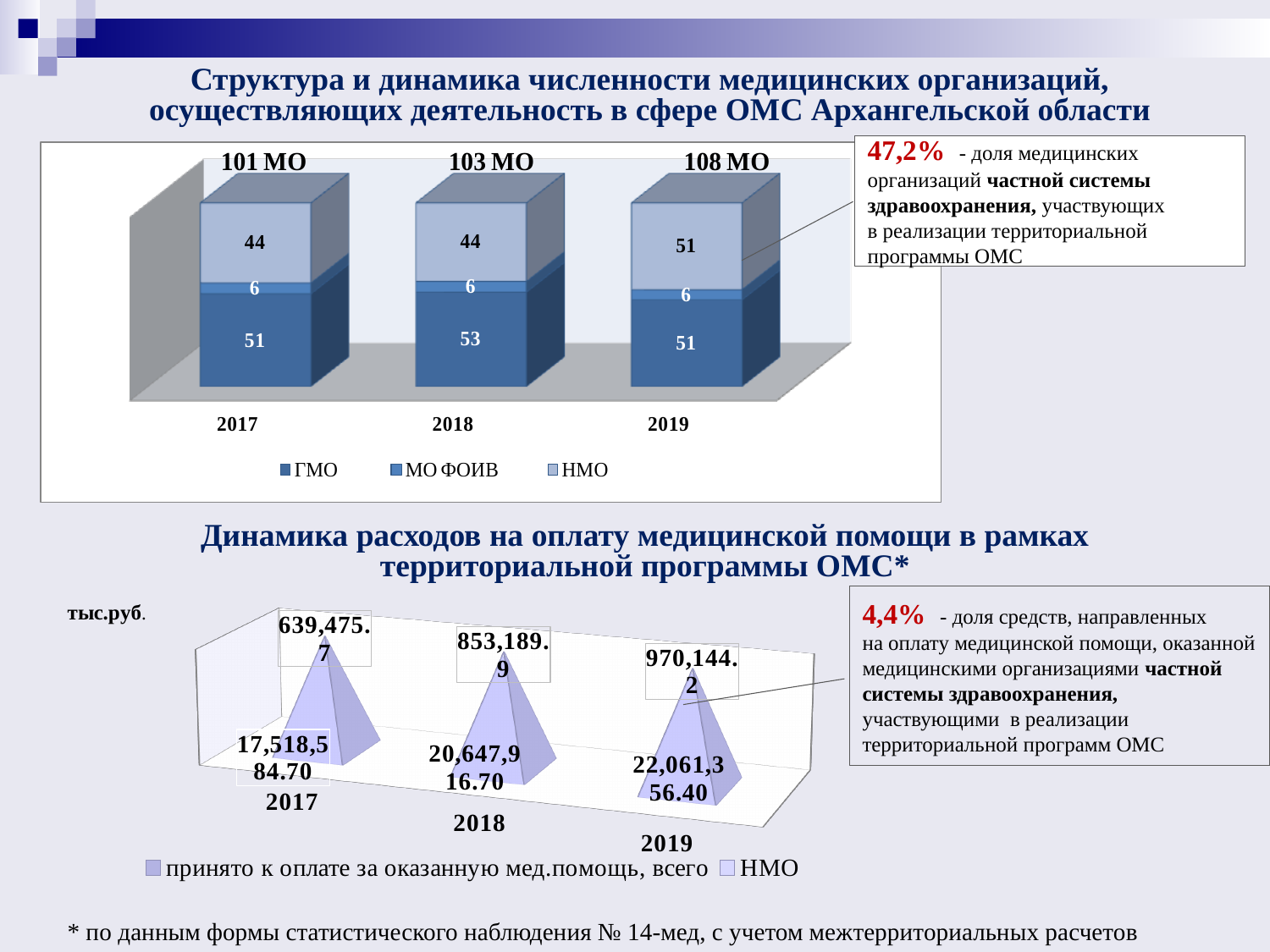
In the bottom chart, what is the НМО value for 2019? 970,144.2 In the top chart, what is the value for НМО in 2019? 51 In the bottom chart, does the value for 'принято к оплате за оказанную мед.помощь, всего' rise or fall from 2017 to 2019? rise What type of chart is the top chart? stacked bar chart In the top chart, what is the value for ГМО in 2018? 53 In the top chart, which year has the highest total number of medical organisations? 2019 In the bottom chart, how many years are shown on the x axis? 3 In the top chart, what is the difference between the НМО values for 2019 and 2018? 7 In the top chart, what is the value for МО ФОИВ in 2017? 6 In the top chart, how many series does the legend list? 3 In the top chart, what is the total number of medical organisations (МО) shown for 2019? 108 МО In the top chart, is the ГМО value for 2018 larger or smaller than the НМО value for 2018? larger